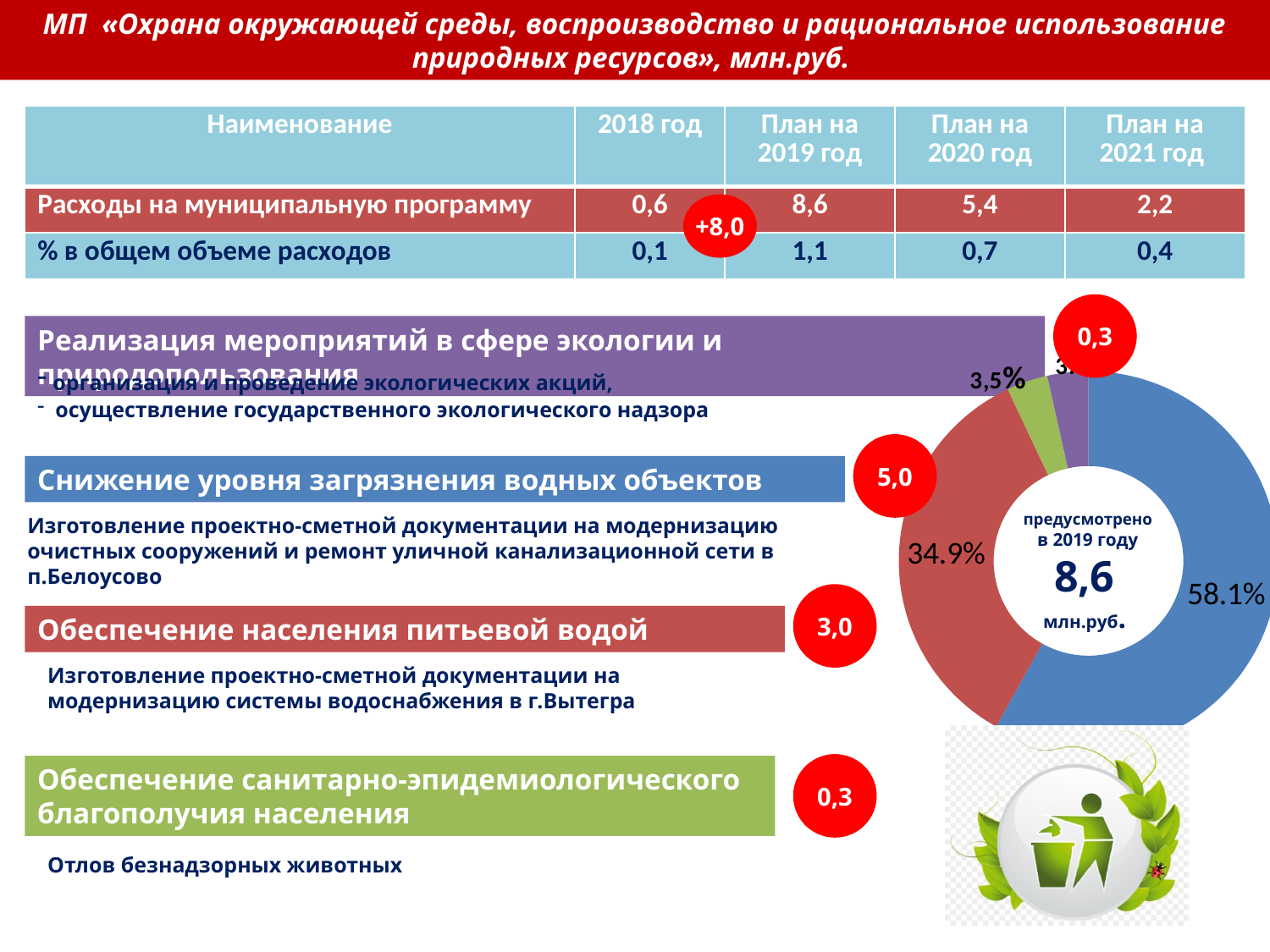
Is the share of the red slice in the doughnut chart greater or less than 50%? less What total amount is shown in the centre of the doughnut chart as planned for 2019? 8,6 млн.руб. What percentage label is shown on the blue slice of the doughnut chart? 58.1% By how many percentage points does the blue slice (58.1%) exceed the red slice (34.9%) in the doughnut chart? 23.2 percentage points How many slices does the doughnut chart contain? 4 What percentage label is shown on the red slice of the doughnut chart? 34.9% Which slice of the doughnut chart is larger, the blue one or the red one? The blue one Is the share of the blue slice in the doughnut chart greater or less than 50%? greater What text is written in the centre of the doughnut chart above the value 8,6? предусмотрено в 2019 году What percentage is shown for the largest slice of the doughnut chart? 58.1% What percentage label is shown on the green slice of the doughnut chart? 3,5% What kind of chart is shown on the right side of the slide? Doughnut (pie) chart